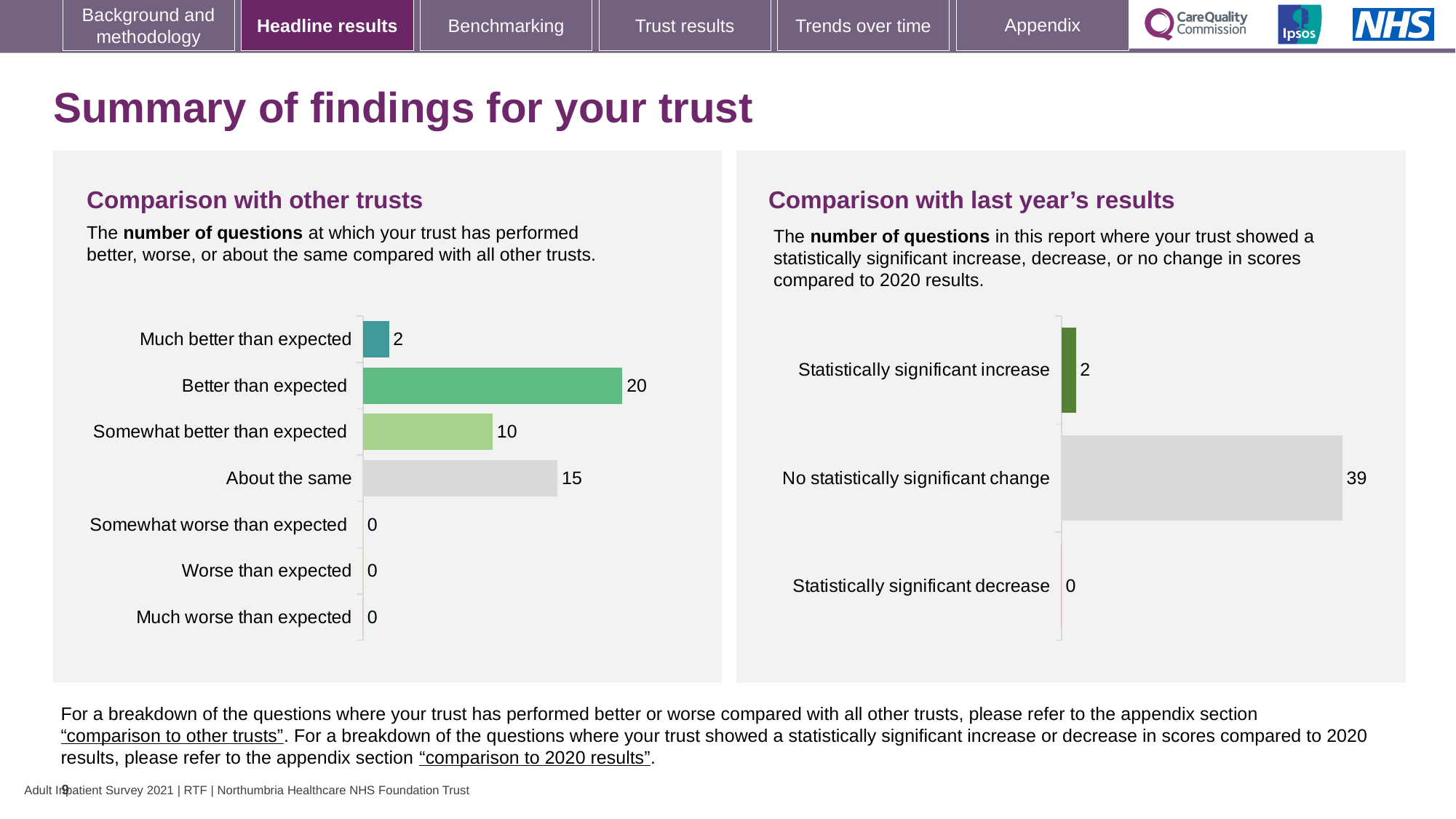
In the 'Comparison with other trusts' chart, is 'About the same' larger or smaller than 'Somewhat better than expected'? Larger In the 'Comparison with other trusts' chart, what is the difference between 'Better than expected' and 'Somewhat better than expected'? 10 What type of chart is used in the 'Comparison with last year's results' panel? Bar chart In the 'Comparison with other trusts' chart, how many questions are 'Better than expected'? 20 In the 'Comparison with other trusts' chart, what is the value for 'Much better than expected'? 2 In the 'Comparison with last year's results' chart, what is the difference between 'No statistically significant change' and 'Statistically significant increase'? 37 In the 'Comparison with other trusts' chart, which category has the highest value? Better than expected In the 'Comparison with other trusts' chart, what is the value for 'About the same'? 15 In the 'Comparison with last year's results' chart, which category has the lowest value? Statistically significant decrease In the 'Comparison with other trusts' chart, how many categories are shown? 7 In the 'Comparison with last year's results' chart, how many questions showed no statistically significant change? 39 In the 'Comparison with last year's results' chart, what is the value for 'Statistically significant decrease'? 0